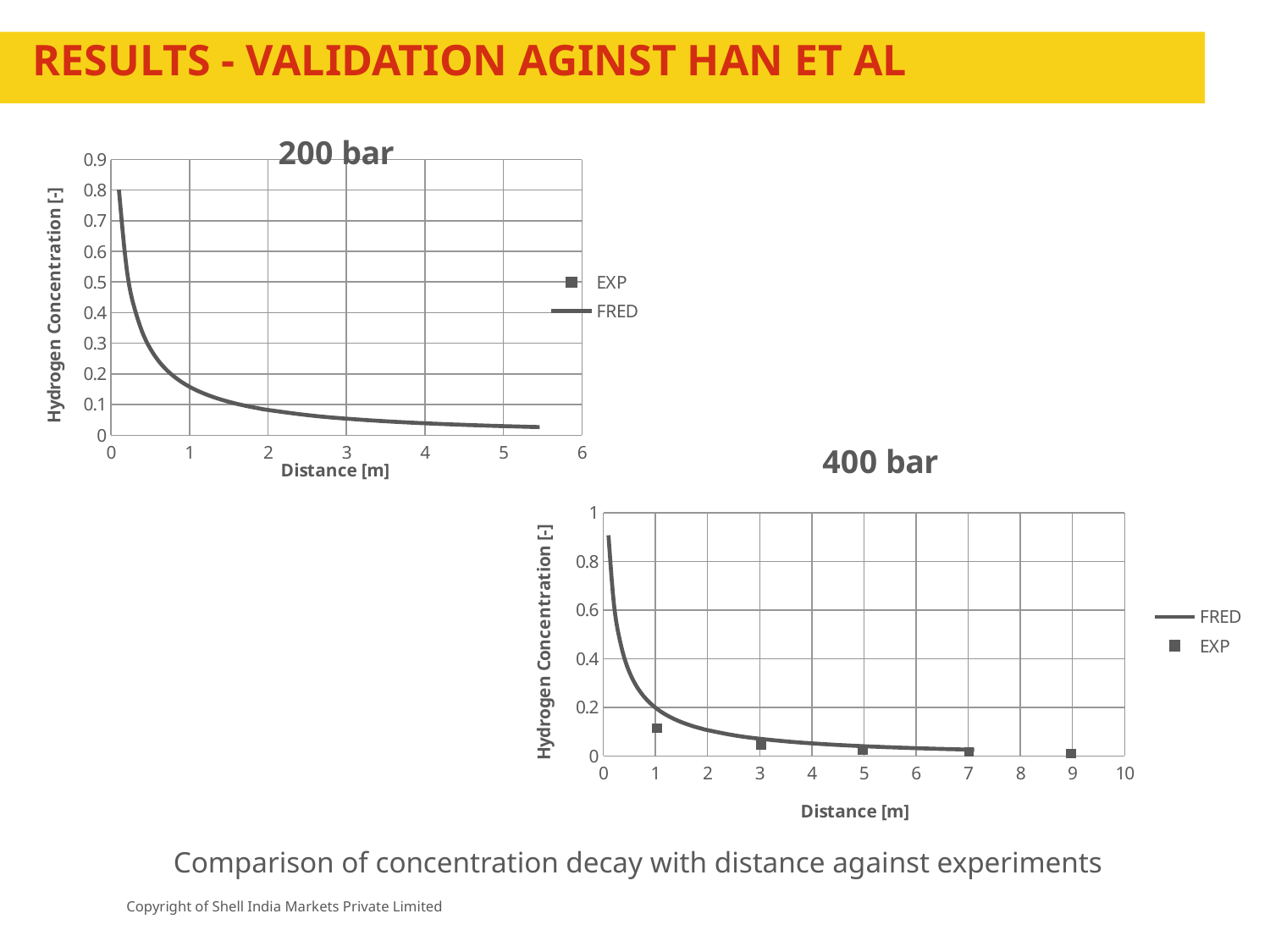
What is the label of the y axis on the "400 bar" chart? Hydrogen Concentration [-] What are the two legend entries shown for the "200 bar" chart? EXP and FRED In the "200 bar" chart, is the starting FRED value near 0 m greater or less than 0.5? greater In the "400 bar" chart, does the hydrogen concentration rise or fall along the x axis? fall In the "400 bar" chart, how many EXP data points are plotted? 5 In the "200 bar" chart, is the FRED value at a distance of 3 m greater or less than 0.1? less How many series does the legend of the "400 bar" chart list? 2 In the "200 bar" chart, does the FRED curve rise or fall as distance increases? fall In the "400 bar" chart, is the FRED value at a distance of 5 m greater or less than 0.2? less What kind of chart is the "200 bar" chart? line chart